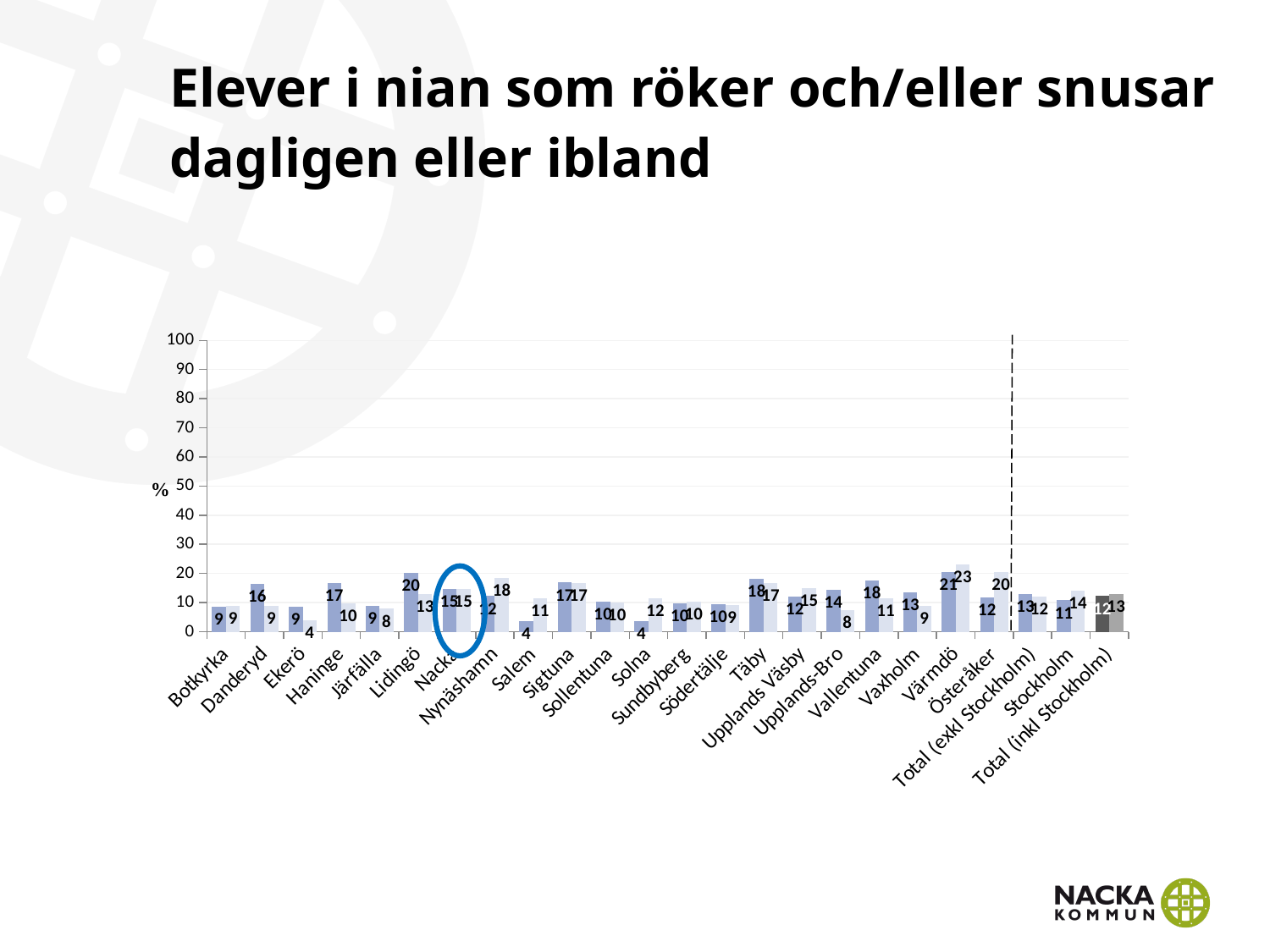
What is the value of the darker (first) bar for Danderyd? 16 How many categories are shown along the x axis of the chart? 24 What are the two values shown for Nacka, the circled category? 15 and 15 What is the title of the chart on the slide? Elever i nian som röker och/eller snusar dagligen eller ibland What is the value of the darker (first) bar for Lidingö? 20 Which category has the highest value in the chart? Värmdö What is the value of the lighter (second) bar for Värmdö? 23 What kind of chart is shown on the slide? bar chart Is the value of the darker (first) bar for Värmdö greater or less than 20? greater What is the difference between the darker bar and the lighter bar for Danderyd? 7 What is the value of the lighter (second) bar for Stockholm? 14 Which is larger for Upplands-Bro: the darker (first) bar or the lighter (second) bar? the darker (first) bar